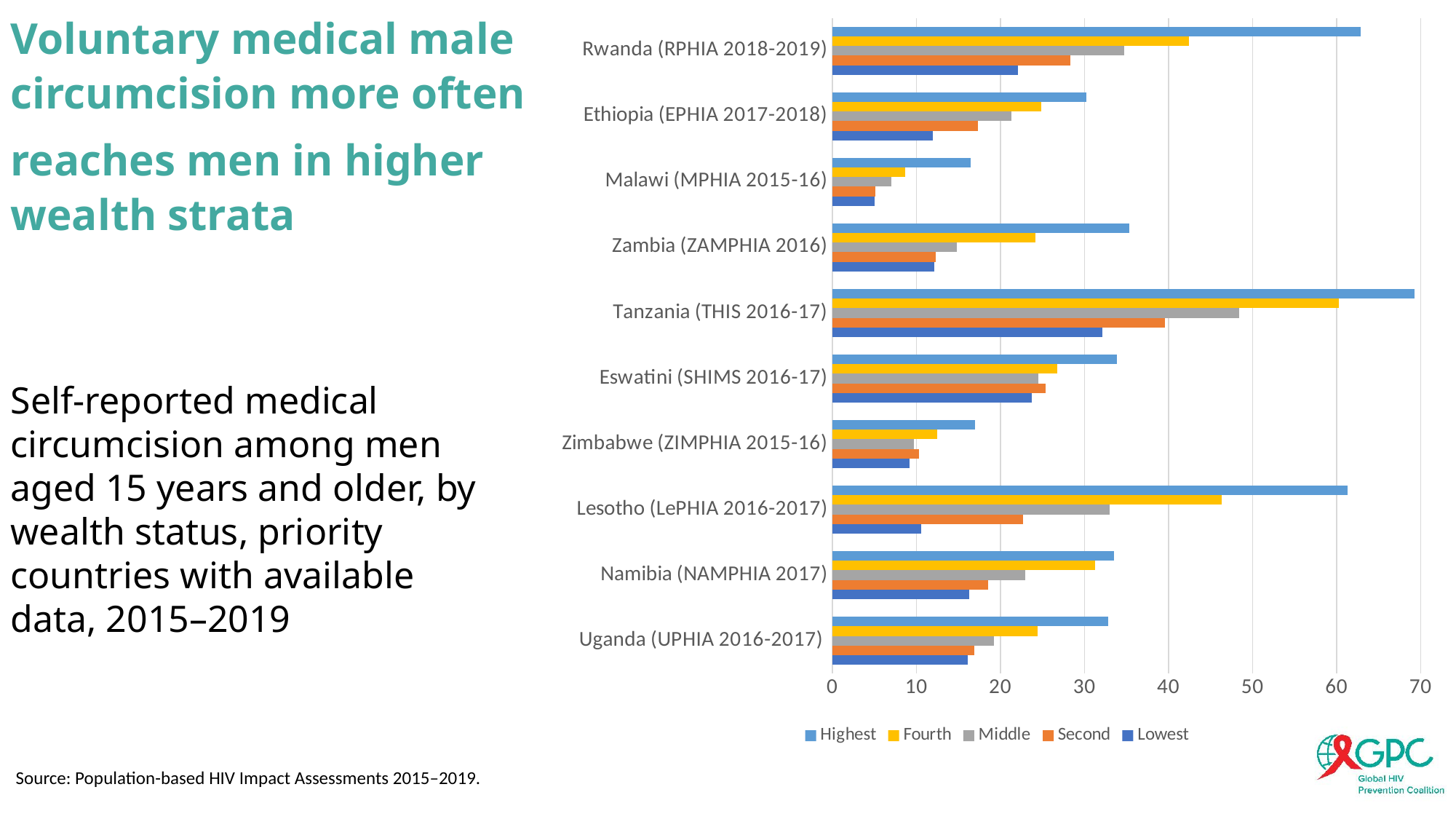
How many countries are shown on the chart? 10 Which country has the lowest value for the Highest wealth group? Malawi (MPHIA 2015-16) Is the value for the Lowest wealth group in Lesotho (LePHIA 2016-2017) greater or less than 20? less Which is larger: the Fourth wealth group value for Tanzania (THIS 2016-17) or for Lesotho (LePHIA 2016-2017)? Tanzania (THIS 2016-17) Which country has the highest value for the Highest wealth group? Tanzania (THIS 2016-17) Is the value for the Highest wealth group in Malawi (MPHIA 2015-16) greater or less than 20? less Which series is listed first in the legend? Highest What kind of chart is shown on the slide? Bar chart Is the value for the Fourth wealth group in Tanzania (THIS 2016-17) greater or less than 50? greater How many series does the legend list? 5 Which wealth group has the highest value in Tanzania (THIS 2016-17)? Highest